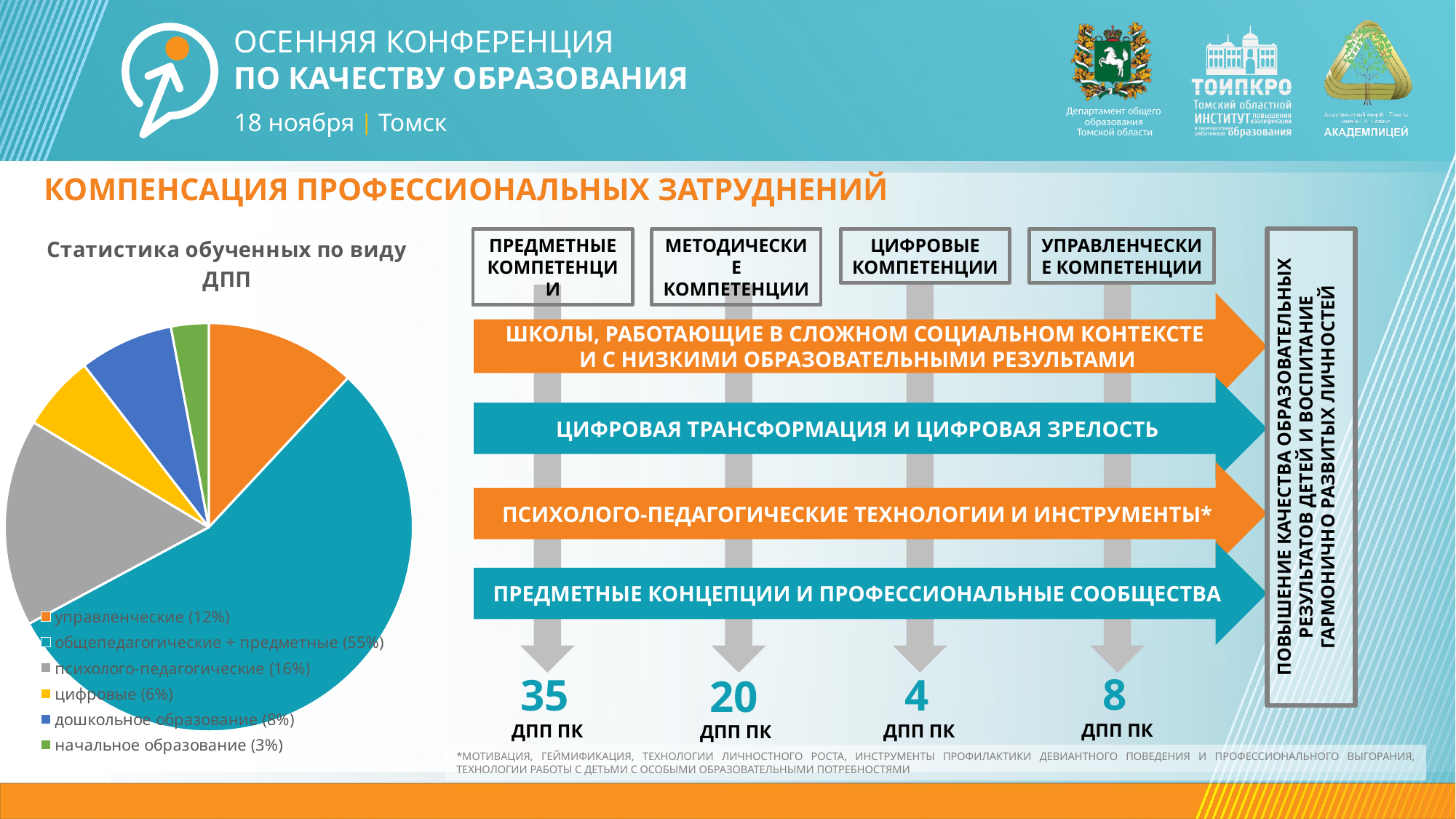
What share of the pie chart is общепедагогические + предметные? 55% What is the value for дошкольное образование in the pie chart? 8% What is the value for управленческие in the pie chart? 12% Which category has the smallest share of the pie chart? начальное образование Which category has the largest share of the pie chart? общепедагогические + предметные What is the value for психолого-педагогические in the pie chart? 16% How many categories does the pie chart have? 6 Which is larger in the pie chart, управленческие or дошкольное образование? управленческие What is the value for цифровые in the pie chart? 6% What is the difference between the shares of общепедагогические + предметные and психолого-педагогические? 39% What kind of chart is shown on the slide? pie chart What is the title of the pie chart? Статистика обученных по виду ДПП